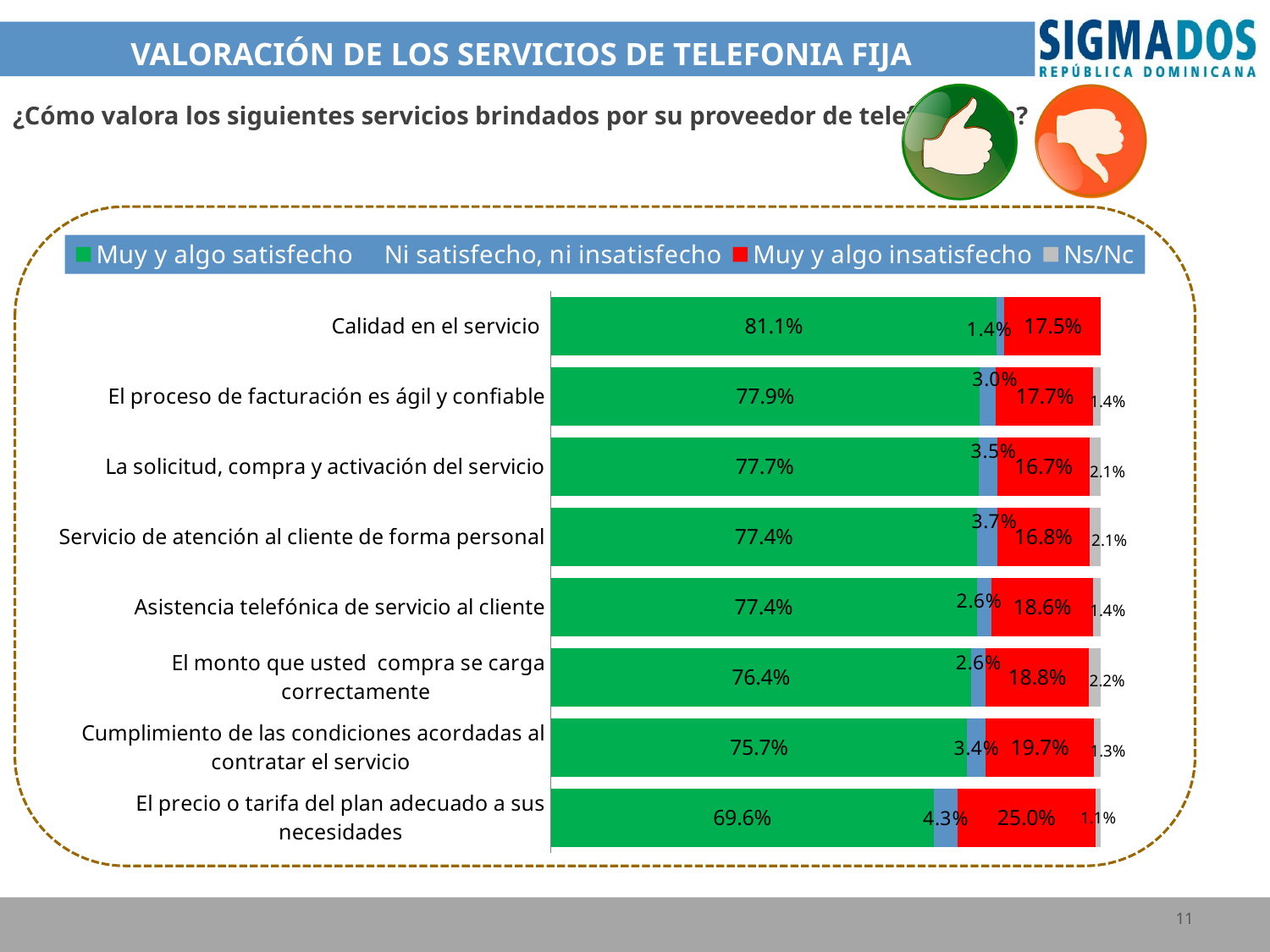
What is the 'Muy y algo insatisfecho' value for 'El precio o tarifa del plan adecuado a sus necesidades'? 25.0% How many series does the legend list? 4 What kind of chart is shown on the slide? Stacked bar chart Which service has the lowest 'Muy y algo satisfecho' percentage? El precio o tarifa del plan adecuado a sus necesidades Which service has the highest 'Muy y algo insatisfecho' percentage? El precio o tarifa del plan adecuado a sus necesidades What is the 'Ni satisfecho, ni insatisfecho' value for 'Servicio de atención al cliente de forma personal'? 3.7% How many services are listed in the chart? 8 What is the 'Ns/Nc' value for 'El monto que usted compra se carga correctamente'? 2.2% Which service has the highest 'Muy y algo satisfecho' percentage? Calidad en el servicio Which has a larger 'Muy y algo insatisfecho' value: 'Cumplimiento de las condiciones acordadas al contratar el servicio' or 'La solicitud, compra y activación del servicio'? Cumplimiento de las condiciones acordadas al contratar el servicio What is the difference between the 'Muy y algo satisfecho' values for 'Calidad en el servicio' and 'El precio o tarifa del plan adecuado a sus necesidades'? 11.5% What percentage of respondents are 'Muy y algo satisfecho' with 'Calidad en el servicio'? 81.1%